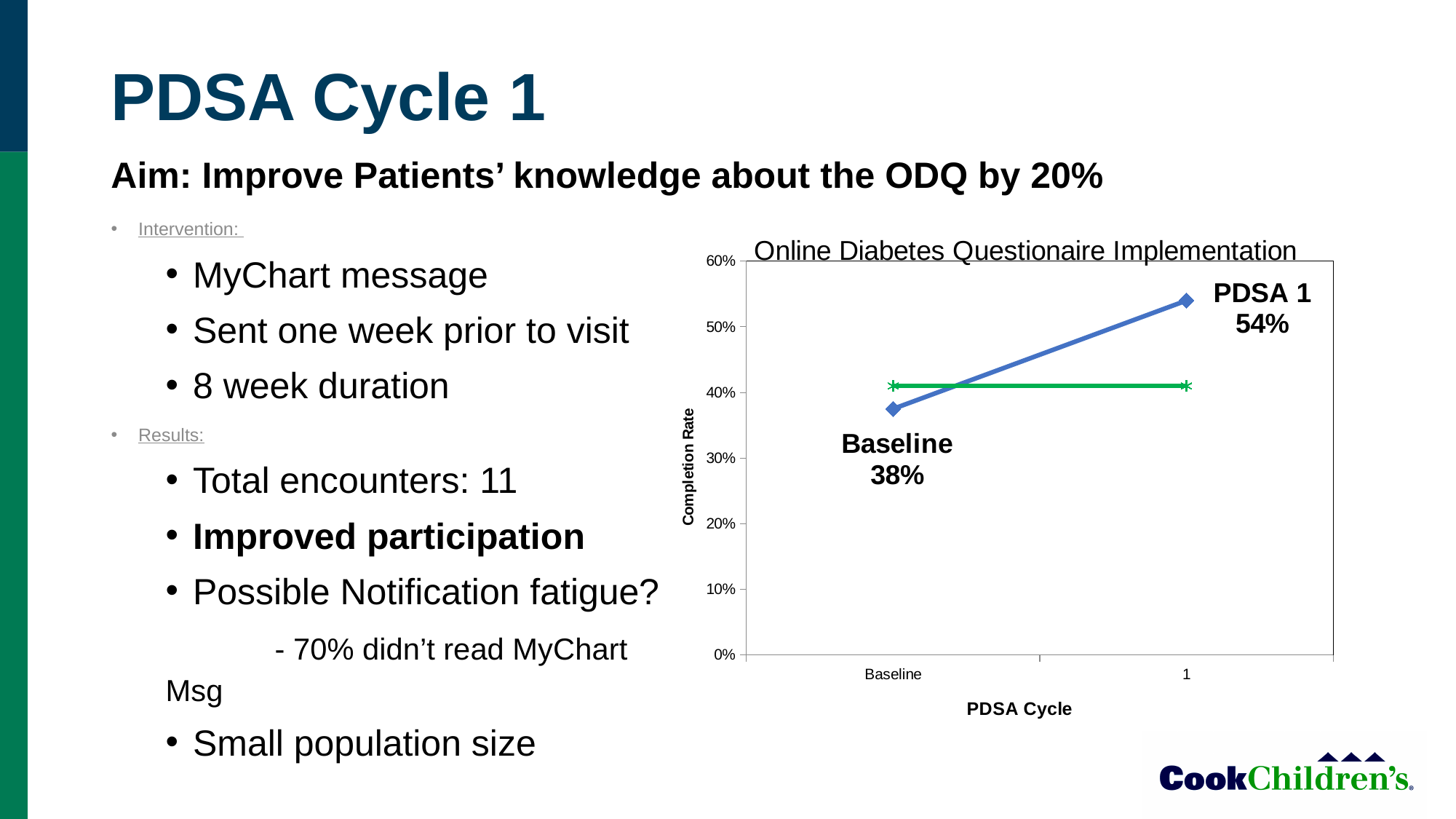
By how many percentage points did the completion rate change from Baseline to PDSA 1? 16% What is the completion rate at Baseline in the Online Diabetes Questionaire Implementation chart? 38% Which point has the higher completion rate, Baseline or PDSA 1? PDSA 1 Is the value of the green horizontal line greater or less than 50%? less What is the label of the y axis of the chart? Completion Rate How many PDSA cycle categories are shown on the x axis of the chart? 2 Does the blue completion rate line rise or fall from Baseline to PDSA cycle 1? rise Which PDSA cycle point has the lowest completion rate on the chart? Baseline What is the title of the chart on the slide? Online Diabetes Questionaire Implementation What kind of chart is shown on the slide? line chart What is the completion rate for PDSA 1 in the chart? 54% Is the PDSA 1 completion rate greater or less than 50%? greater